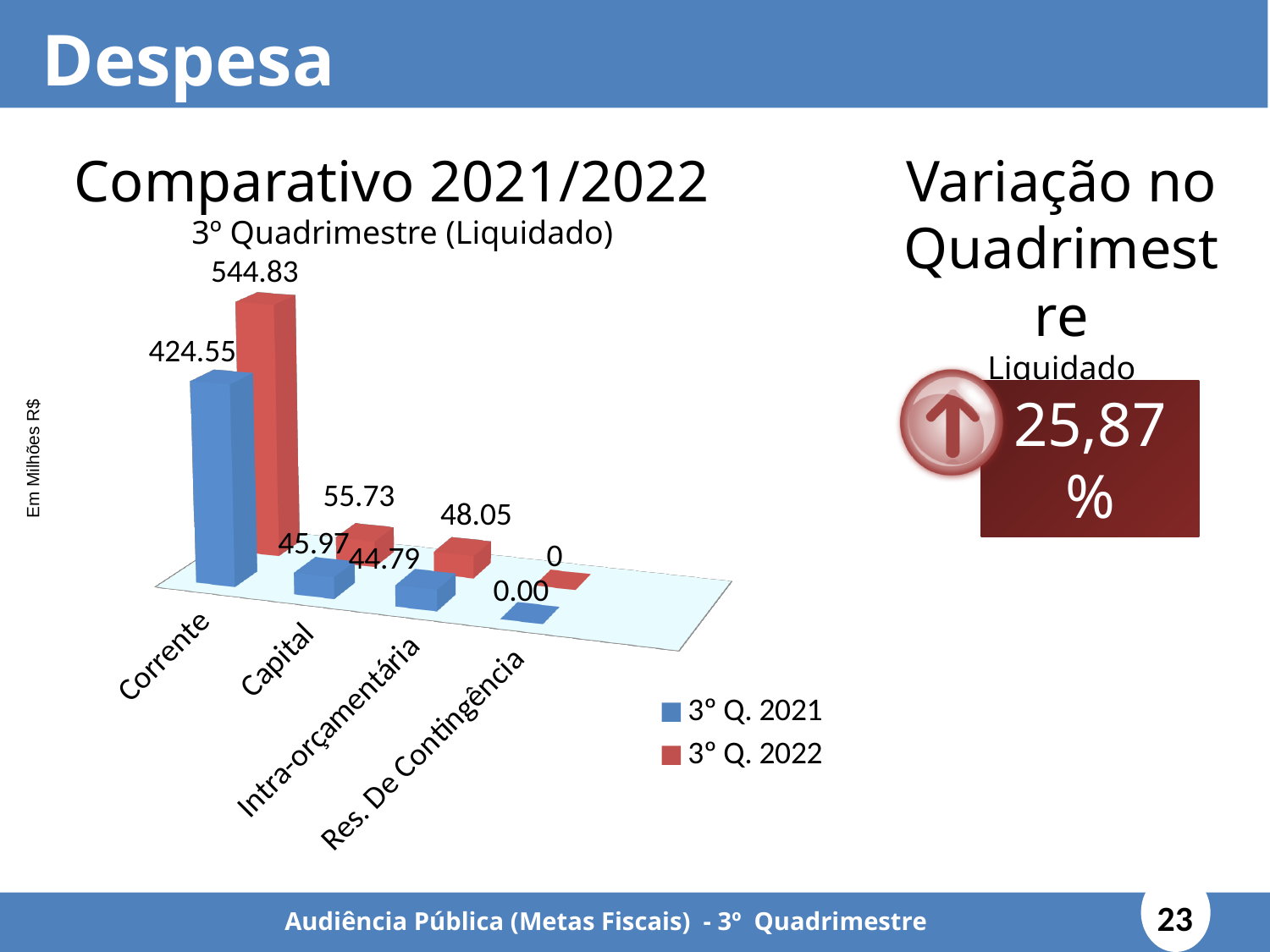
What unit is indicated on the vertical axis label of the chart? Em Milhões R$ Which category has the highest value in the 3º Q. 2022 series? Corrente What is the difference between the 3º Q. 2022 and 3º Q. 2021 values for Corrente? 120.28 What is the value for Corrente in the 3º Q. 2022 series? 544.83 What is the value for Corrente in the 3º Q. 2021 series? 424.55 Which is larger for Capital: the 3º Q. 2021 value or the 3º Q. 2022 value? 3º Q. 2022 Which category has the lowest value in the 3º Q. 2021 series? Res. De Contingência How many categories are shown on the x axis of the chart? 4 What kind of chart is shown on the slide? Bar chart What is the value for Capital in the 3º Q. 2022 series? 55.73 How many series does the chart legend list? 2 What is the value for Intra-orçamentária in the 3º Q. 2021 series? 44.79